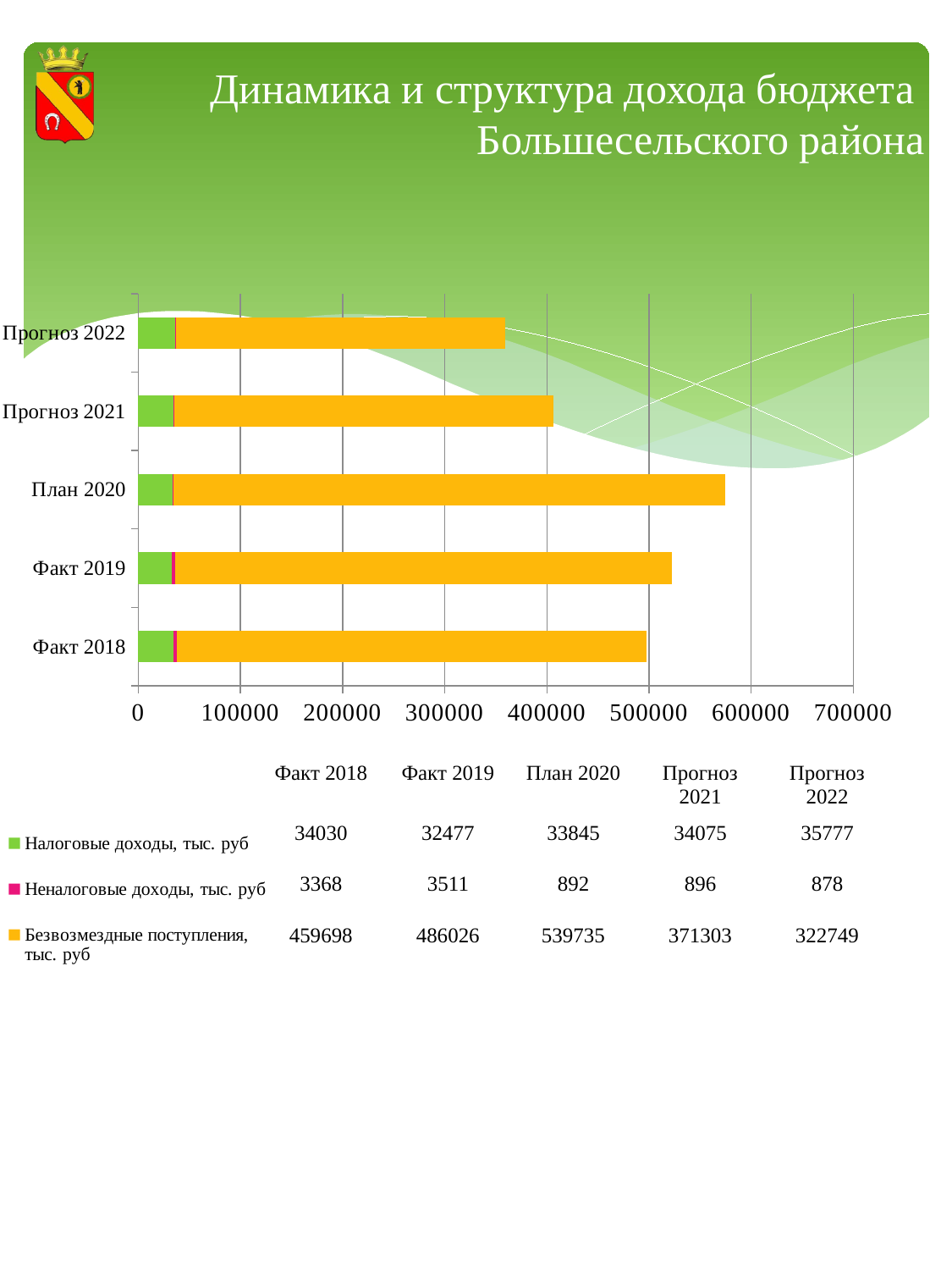
What is the total of the stacked bar for Факт 2018? 497096 Which category has the lowest value for Неналоговые доходы, тыс. руб? Прогноз 2022 Which is larger: Налоговые доходы, тыс. руб for Факт 2018 or for Прогноз 2022? Прогноз 2022 What type of chart is shown on the slide? Stacked bar chart How many categories are plotted on the chart? 5 How many series does the legend list? 3 Which category has the highest value for Безвозмездные поступления, тыс. руб? План 2020 What is the value of Неналоговые доходы, тыс. руб for План 2020? 892 Is the total value of the bar for Прогноз 2022 greater or less than 400000? less What is the difference between Безвозмездные поступления, тыс. руб for План 2020 and Факт 2019? 53709 What is the value of Налоговые доходы, тыс. руб for Факт 2019? 32477 What is the value of Безвозмездные поступления, тыс. руб for Прогноз 2021? 371303